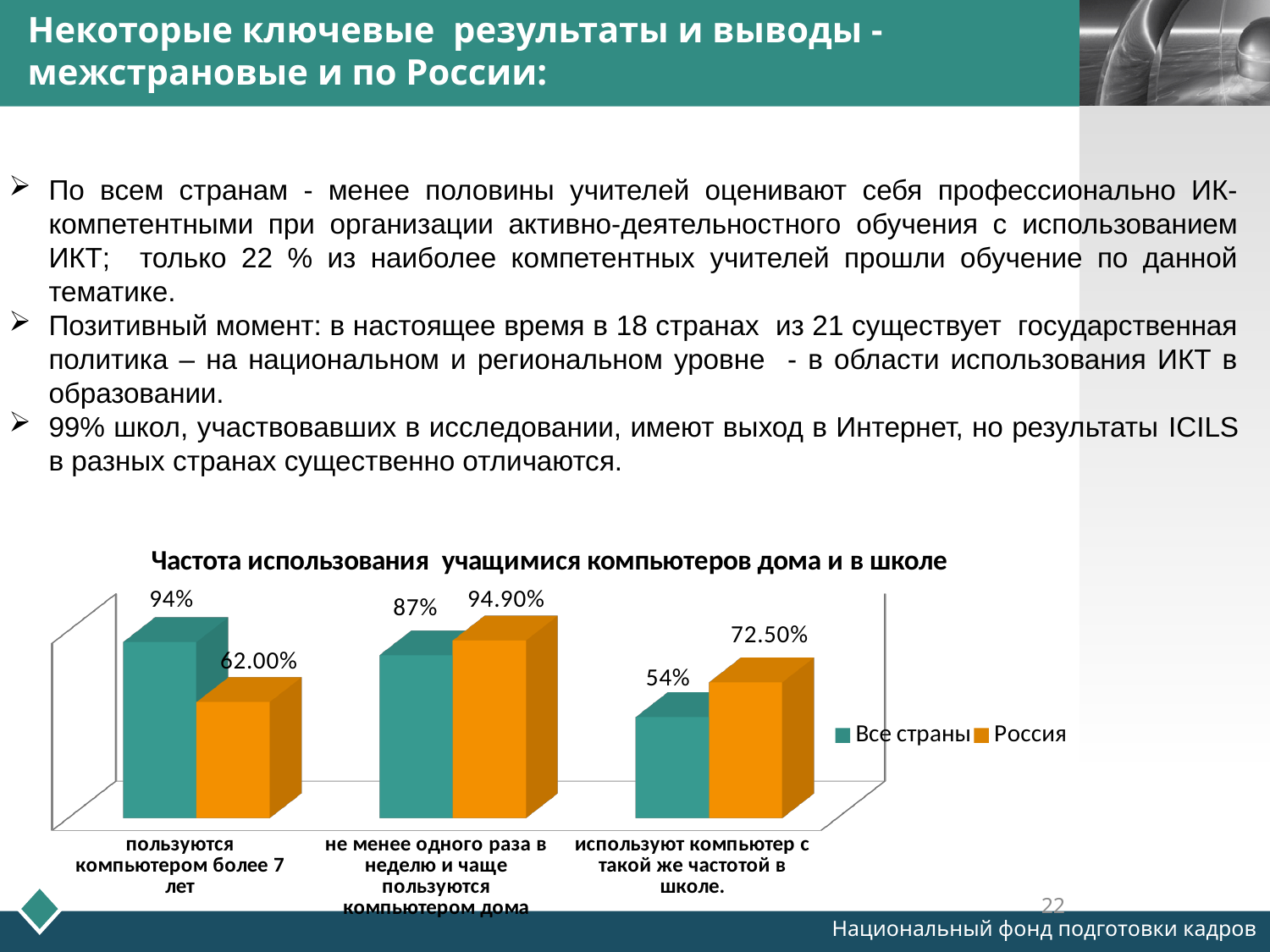
How many categories are shown on the chart's x axis? 3 What is the title of the chart on the slide? Частота использования учащимися компьютеров дома и в школе What is the value for "Россия" in the category "не менее одного раза в неделю и чаще пользуются компьютером дома"? 94.90% What type of chart is shown on the slide? bar chart What is the value for "Все страны" in the category "пользуются компьютером более 7 лет"? 94% In the category "используют компьютер с такой же частотой в школе", which series has the larger value, "Все страны" or "Россия"? Россия How many series does the chart legend list? 2 What is the difference between the "Россия" and "Все страны" values in the category "используют компьютер с такой же частотой в школе"? 18.5 percentage points What is the value for "Россия" in the category "пользуются компьютером более 7 лет"? 62.00% What is the value for "Все страны" in the category "используют компьютер с такой же частотой в школе"? 54% Which category has the lowest value for the "Все страны" series? используют компьютер с такой же частотой в школе Which category has the highest value for the "Россия" series? не менее одного раза в неделю и чаще пользуются компьютером дома